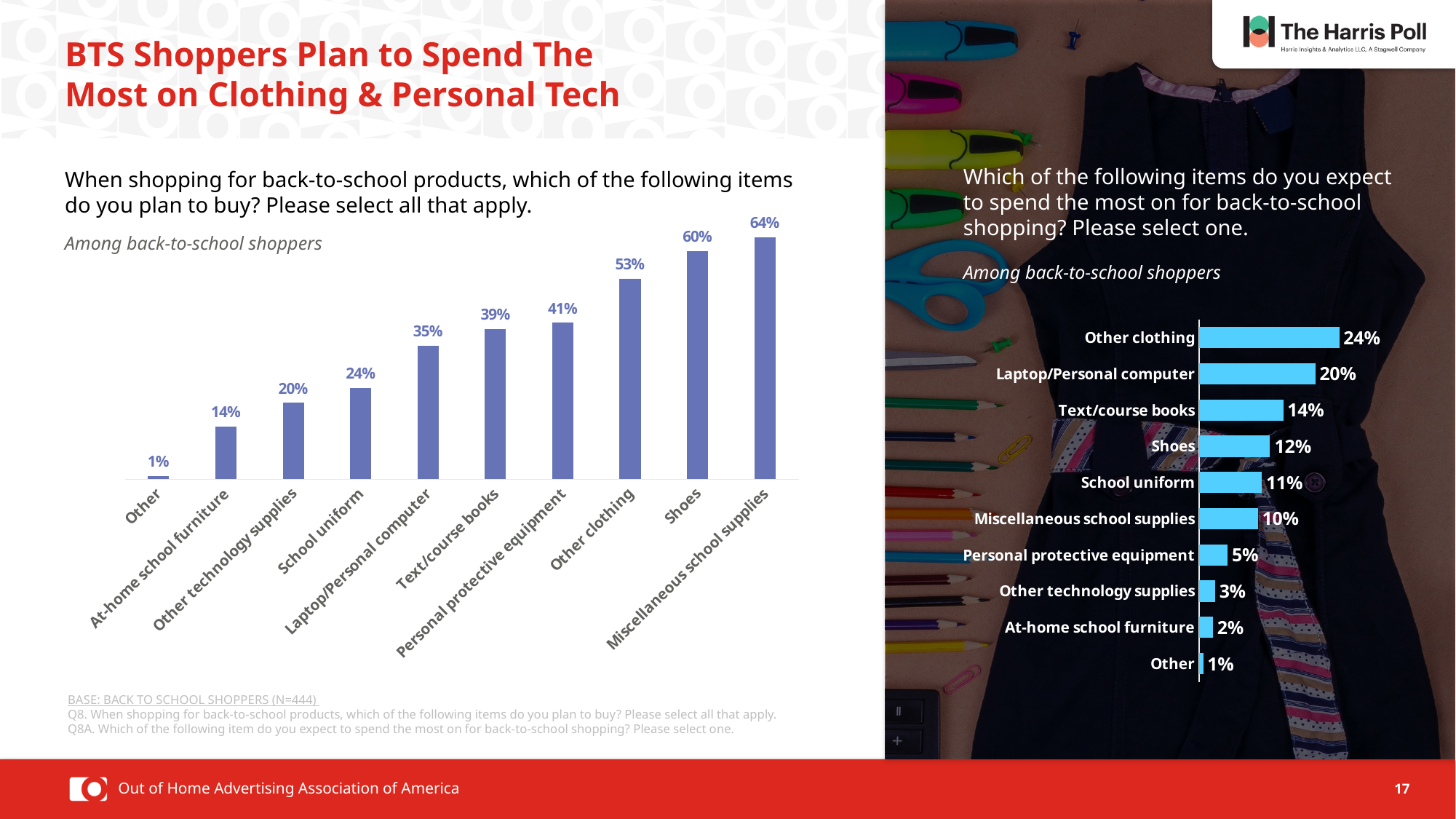
In the left chart (items shoppers plan to buy), how many items are shown on the x axis? 10 In the left chart (items shoppers plan to buy), what percentage of back-to-school shoppers plan to buy Shoes? 60% In the left chart (items shoppers plan to buy), do the values rise or fall from left to right along the x axis? rise In the left chart (items shoppers plan to buy), what is the difference between the percentages for Other clothing and School uniform? 29% In the left chart (items shoppers plan to buy), what percentage plan to buy Personal protective equipment? 41% In the left chart (items shoppers plan to buy), which item has the highest percentage? Miscellaneous school supplies In the left chart (items shoppers plan to buy), which item has the lowest percentage? Other In the right chart (item shoppers expect to spend the most on), which is larger: Text/course books or Shoes? Text/course books In the right chart (item shoppers expect to spend the most on), which item has the highest percentage? Other clothing In the right chart (item shoppers expect to spend the most on), what percentage selected Laptop/Personal computer? 20% In the right chart (item shoppers expect to spend the most on), what is the difference between Other clothing and Personal protective equipment? 19% What kind of chart is the right chart (item shoppers expect to spend the most on)? bar chart